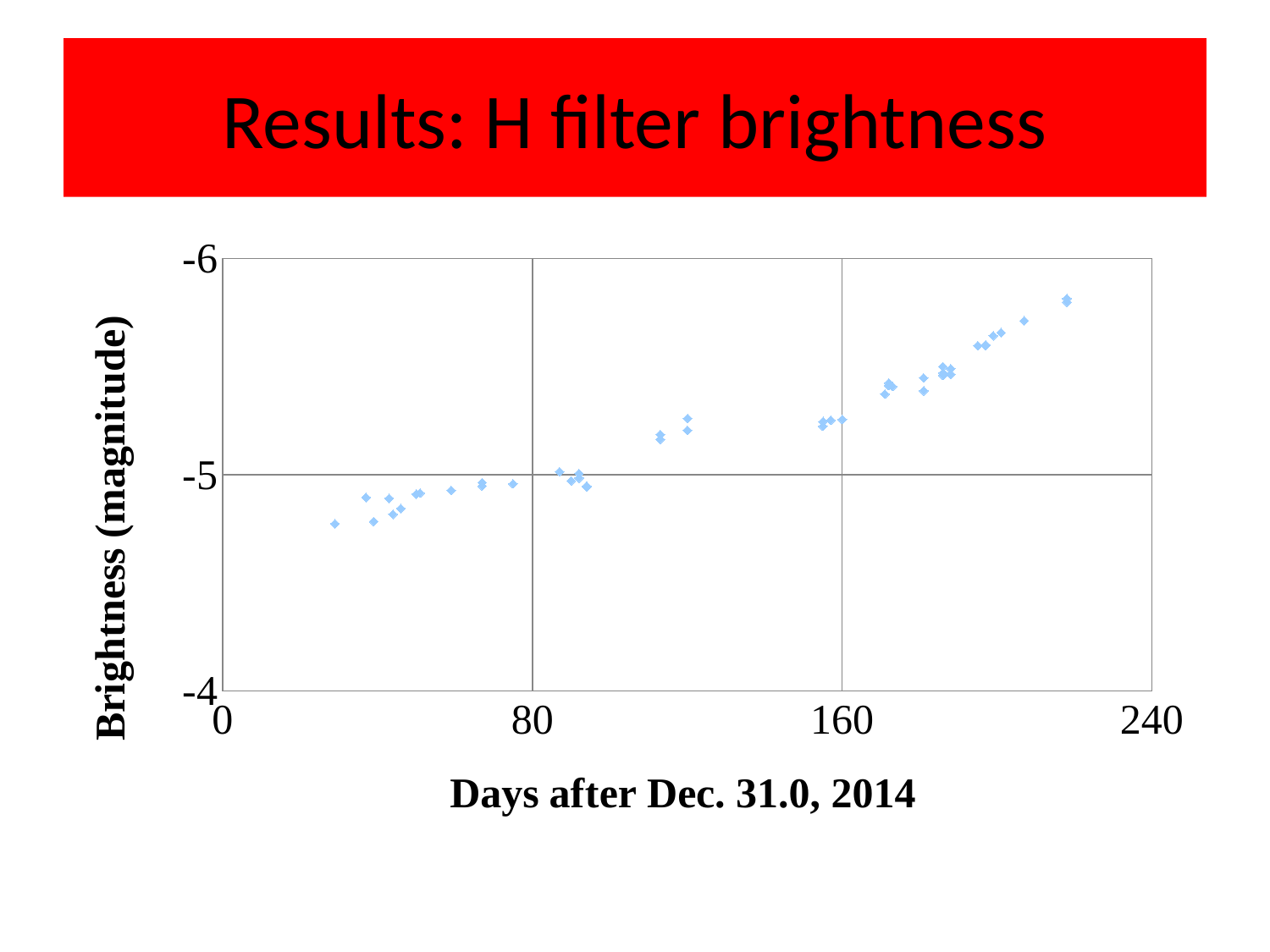
What kind of chart is shown on the slide? scatter chart What is the title of the y axis? Brightness (magnitude) As the number of days increases along the x axis, do the plotted points move up or down the chart? up Is the brightness magnitude for the point near day 30 greater or less than -5? greater What is the title of the x axis? Days after Dec. 31.0, 2014 Are any points plotted beyond day 240 on the x axis? No Are the points near day 200 plotted above or below the -5 gridline? above Is the point plotted highest on the chart at the left end or the right end of the data? right end What is the largest value labelled on the x axis? 240